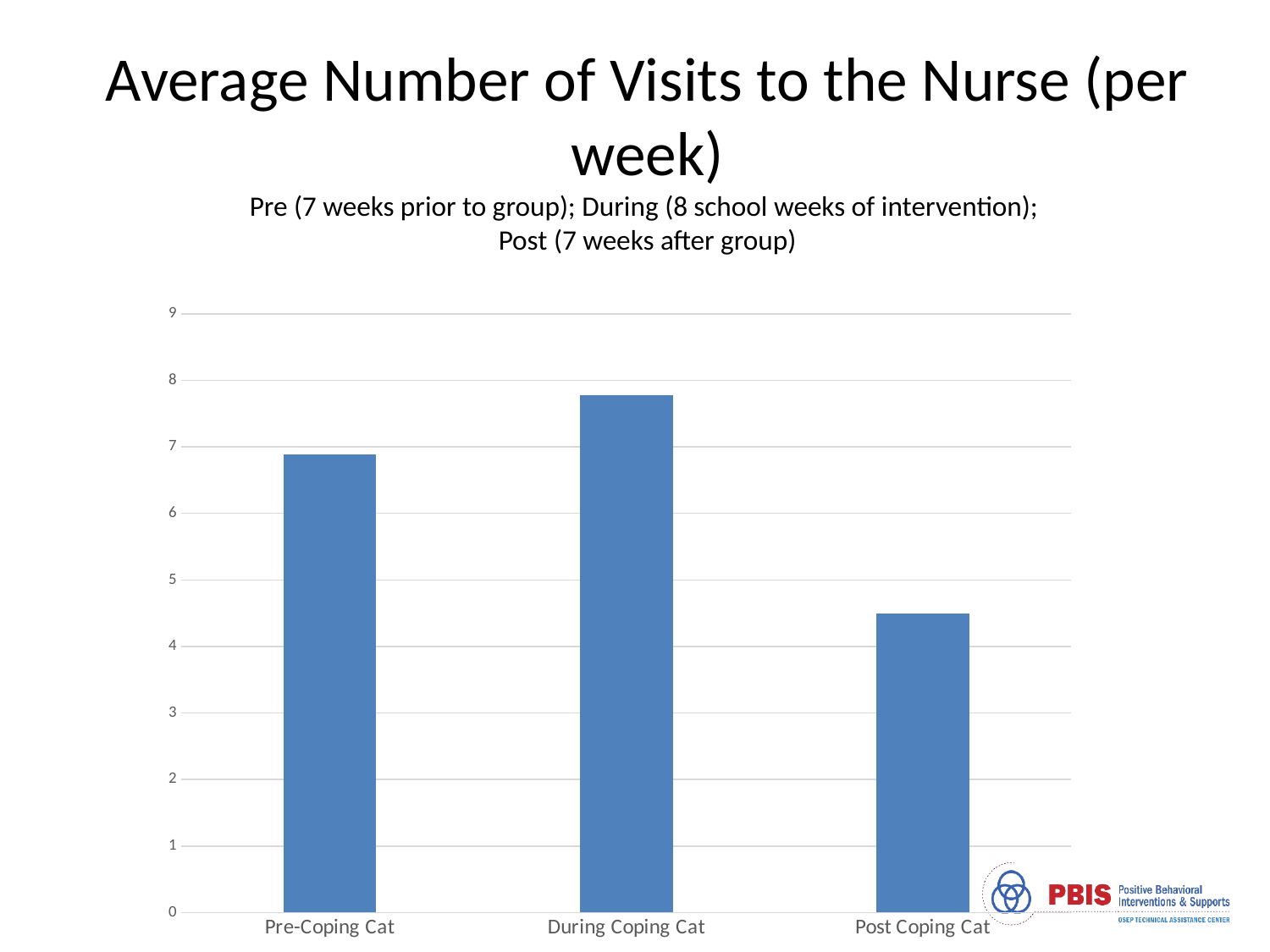
Is the value for During Coping Cat greater or less than 7? greater How many categories are plotted on the chart? 3 Is the value for Pre-Coping Cat greater or less than 6? greater What is the title of the chart on the slide? Average Number of Visits to the Nurse (per week) Which is larger, the value for Pre-Coping Cat or the value for Post Coping Cat? Pre-Coping Cat Which is larger, the value for During Coping Cat or the value for Pre-Coping Cat? During Coping Cat Is the value for Post Coping Cat greater or less than 4? greater What kind of chart is shown on the slide? bar chart Which category has the highest average number of visits to the nurse? During Coping Cat Which category has the lowest average number of visits to the nurse? Post Coping Cat Do the values rise or fall from During Coping Cat to Post Coping Cat? fall